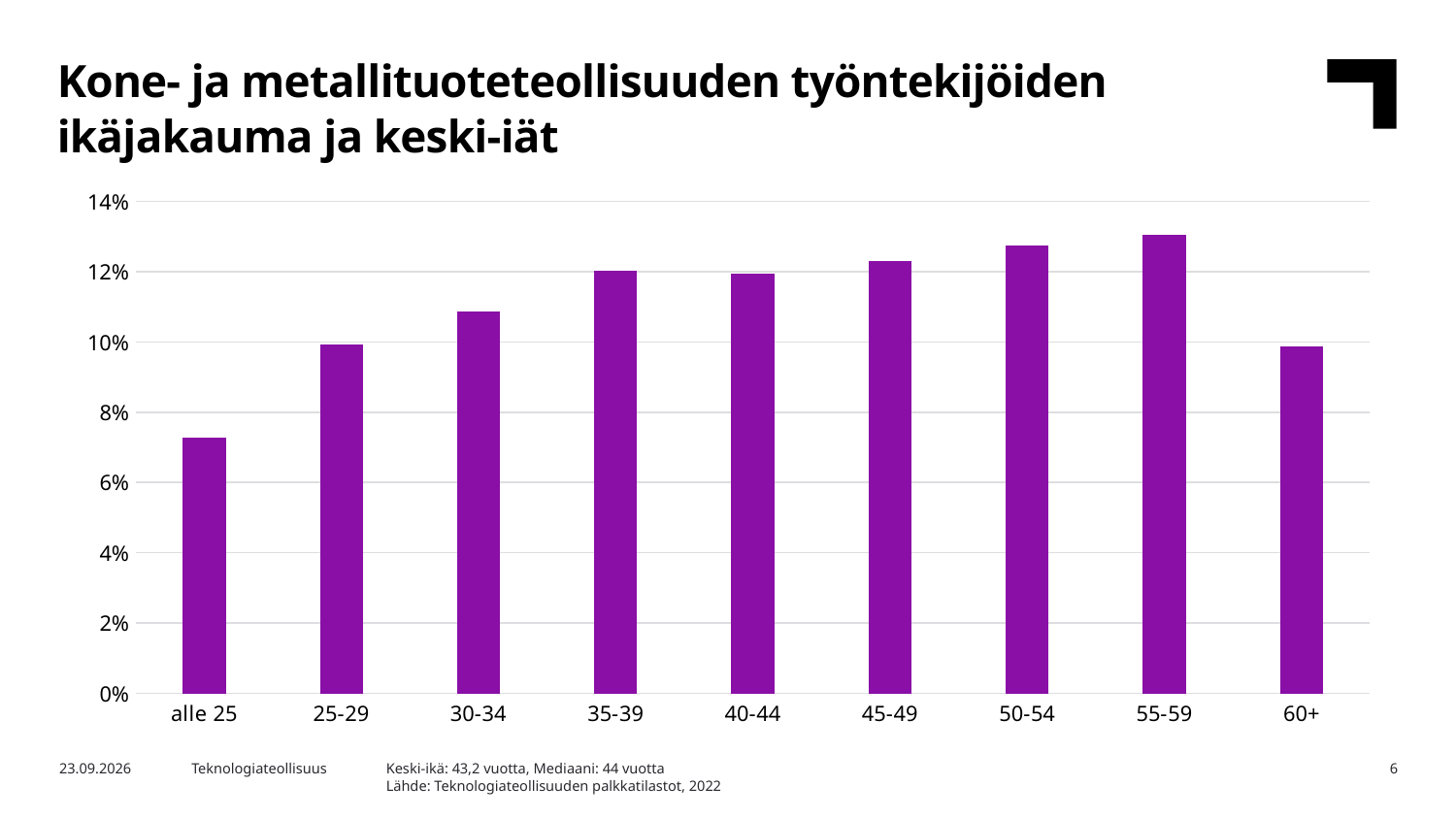
Is the value for 60+ greater or less than 8%? greater Which age group has the lowest share? alle 25 Which age group has the highest share? 55-59 What colour are the bars in the chart? purple Which has a larger share, 30-34 or 25-29? 30-34 How many age groups are shown on the x axis? 9 Is the value for 55-59 greater or less than 12%? greater Is the value for alle 25 greater or less than 8%? less What kind of chart is shown on the slide? bar chart Which has a larger share, 50-54 or 60+? 50-54